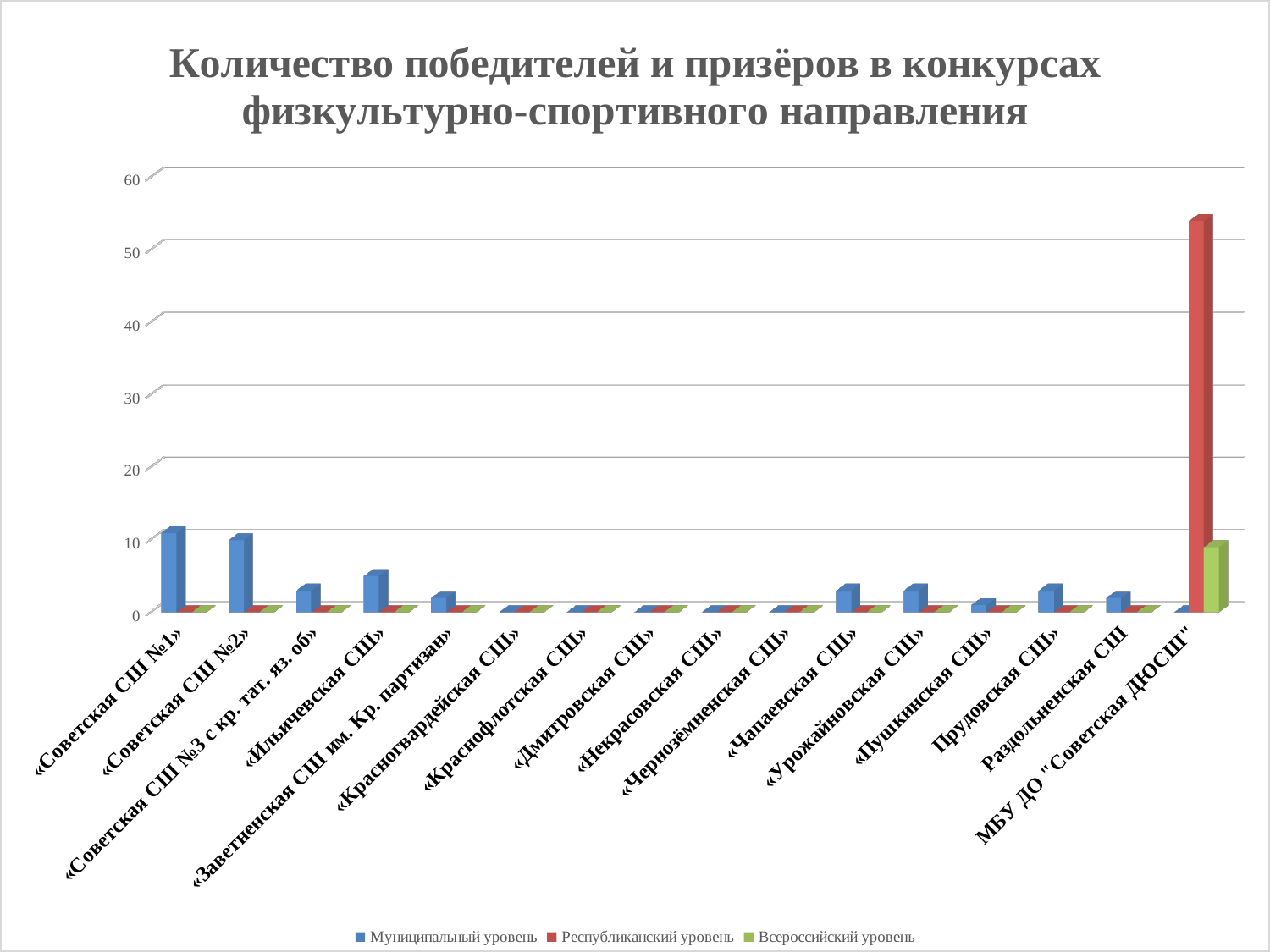
Which has the larger Муниципальный уровень value: «Советская СШ №1» or «Ильичевская СШ»? «Советская СШ №1» Which category has the tallest bar in the chart? МБУ ДО "Советская ДЮСШ" How many categories (schools) are shown on the x axis? 16 How many series does the legend list? 3 Which series has the tallest bar for МБУ ДО "Советская ДЮСШ"? Республиканский уровень Which has the larger Муниципальный уровень value: «Ильичевская СШ» or «Советская СШ №3 с кр. тат. яз. об»? «Ильичевская СШ» Is the Республиканский уровень value for МБУ ДО "Советская ДЮСШ" greater or less than 50? greater What colour represents the Республиканский уровень series? red What kind of chart is shown on the slide? bar chart Is the Муниципальный уровень value for «Ильичевская СШ» greater or less than 10? less Is the Всероссийский уровень value for МБУ ДО "Советская ДЮСШ" greater or less than 20? less